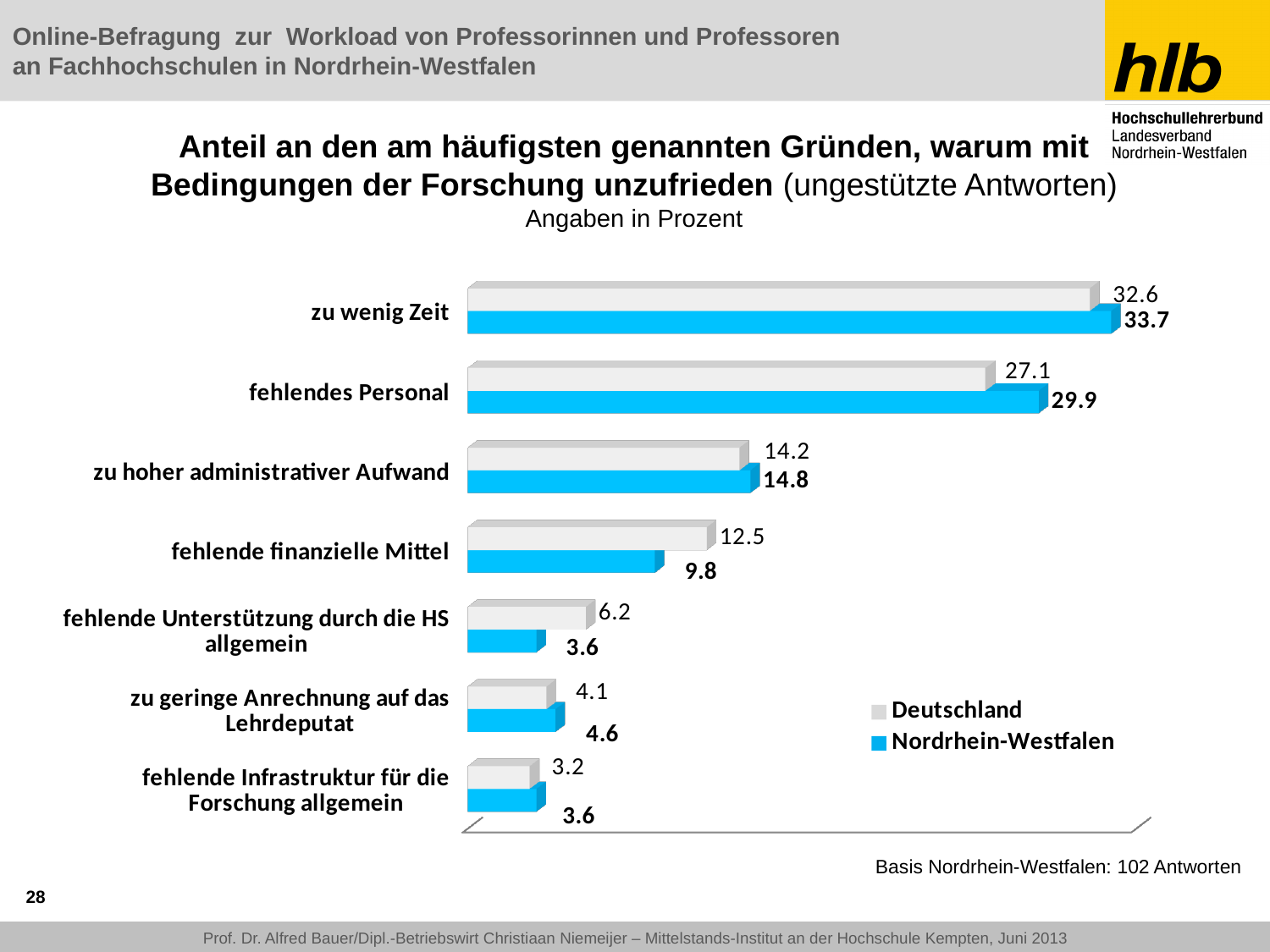
How many series does the legend list? 2 What is the value for Nordrhein-Westfalen for "fehlende finanzielle Mittel"? 9.8 Which category has the lowest value for Deutschland? fehlende Infrastruktur für die Forschung allgemein Which category has the highest value for Nordrhein-Westfalen? zu wenig Zeit Which colour represents Nordrhein-Westfalen in the chart? blue What is the value for Deutschland for "fehlende Unterstützung durch die HS allgemein"? 6.2 For "fehlende finanzielle Mittel", which is larger: the Deutschland value or the Nordrhein-Westfalen value? Deutschland What is the difference between the Nordrhein-Westfalen and Deutschland values for "fehlendes Personal"? 2.8 What is the value for Deutschland for "fehlendes Personal"? 27.1 What is the value for Nordrhein-Westfalen for "zu wenig Zeit"? 33.7 What kind of chart is shown on the slide? bar chart How many categories are shown in the chart? 7